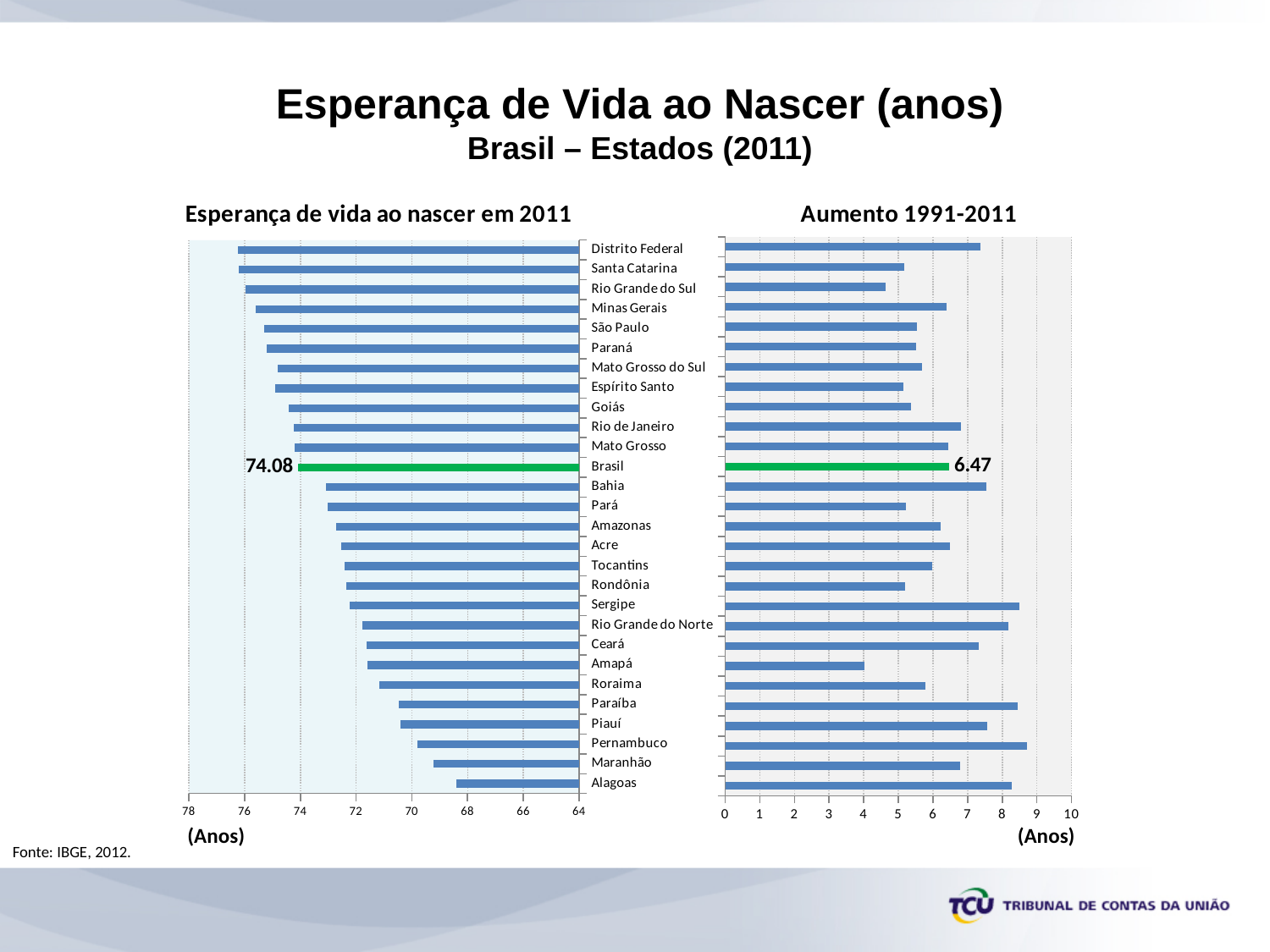
How many categories are plotted in the left chart (Esperança de vida ao nascer em 2011)? 28 In the left chart (Esperança de vida ao nascer em 2011), what is the value for Brasil? 74.08 In the left chart (Esperança de vida ao nascer em 2011), is the value for Minas Gerais greater or less than 74? greater In the right chart (Aumento 1991-2011), what is the value for Brasil? 6.47 In the right chart (Aumento 1991-2011), is the value for Pernambuco greater or less than 8? greater In the left chart (Esperança de vida ao nascer em 2011), do the values increase or decrease going from the top category to the bottom category? decrease What kind of chart is the left chart (Esperança de vida ao nascer em 2011)? bar chart In the left chart (Esperança de vida ao nascer em 2011), is the value for Alagoas greater or less than 70? less In the right chart (Aumento 1991-2011), which is larger, the value for Bahia or the value for Pará? Bahia What unit is shown on the horizontal axis of both charts? (Anos) In the left chart (Esperança de vida ao nascer em 2011), which category has the lowest value? Alagoas In the right chart (Aumento 1991-2011), which category has the lowest value? Amapá